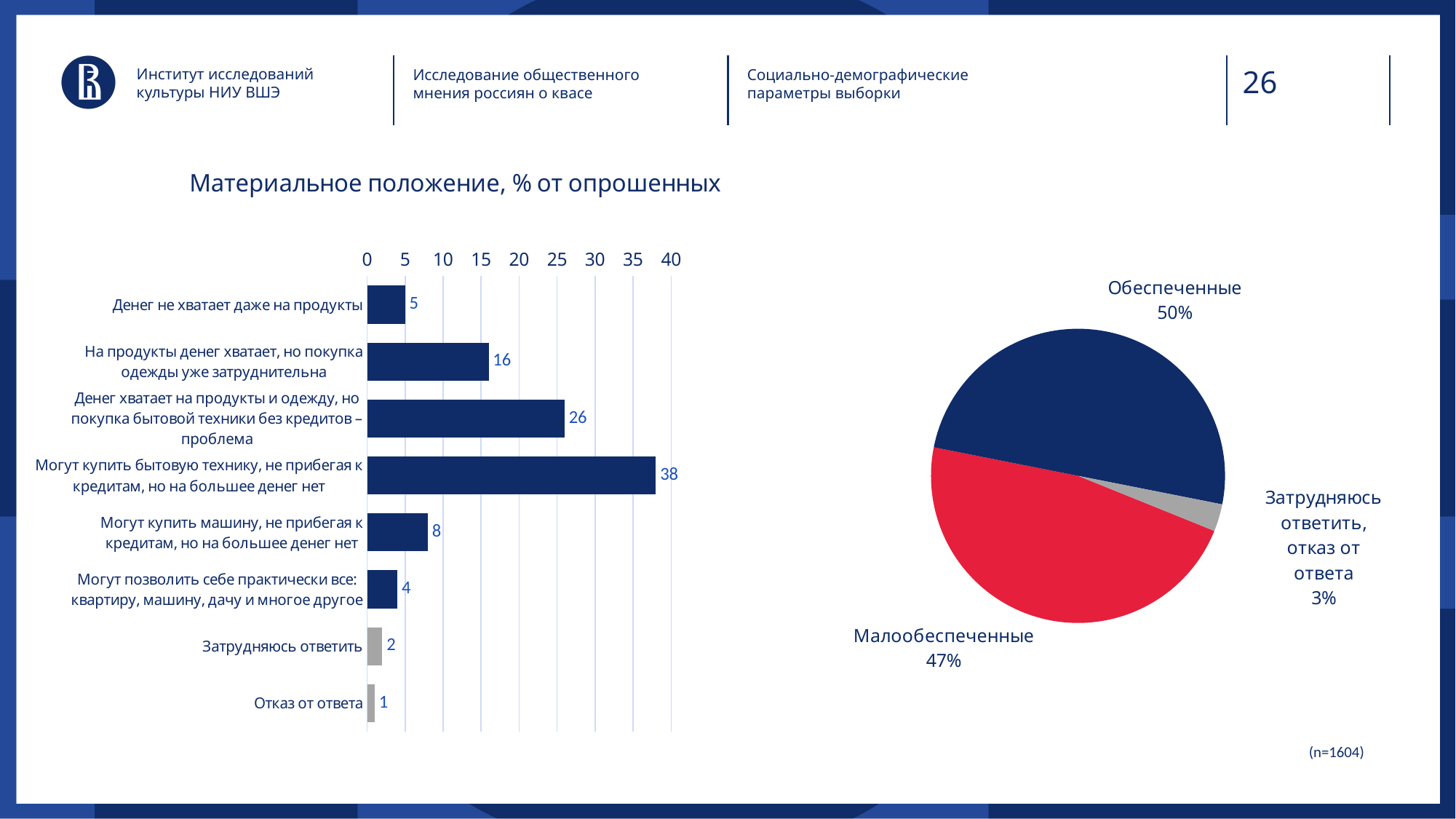
How many categories does the bar chart on the left show? 8 In the bar chart on the left, what is the value for 'Денег не хватает даже на продукты'? 5 In the bar chart on the left, what is the difference between the values for 'Денег хватает на продукты и одежду, но покупка бытовой техники без кредитов – проблема' and 'На продукты денег хватает, но покупка одежды уже затруднительна'? 10 In the bar chart on the left, which category has the highest value? Могут купить бытовую технику, не прибегая к кредитам, но на большее денег нет In the bar chart on the left, what is the value for 'Могут купить бытовую технику, не прибегая к кредитам, но на большее денег нет'? 38 In the bar chart on the left, which is larger: the value for 'Могут купить машину, не прибегая к кредитам, но на большее денег нет' or for 'Могут позволить себе практически все: квартиру, машину, дачу и многое другое'? Могут купить машину, не прибегая к кредитам, но на большее денег нет What kind of chart is on the left side of the slide? Bar chart In the pie chart on the right, what share is 'Обеспеченные'? 50% In the pie chart on the right, which slice is the smallest? Затрудняюсь ответить, отказ от ответа What is the title of the chart on the left? Материальное положение, % от опрошенных In the bar chart on the left, which category has the lowest value? Отказ от ответа In the pie chart on the right, what share is 'Малообеспеченные'? 47%